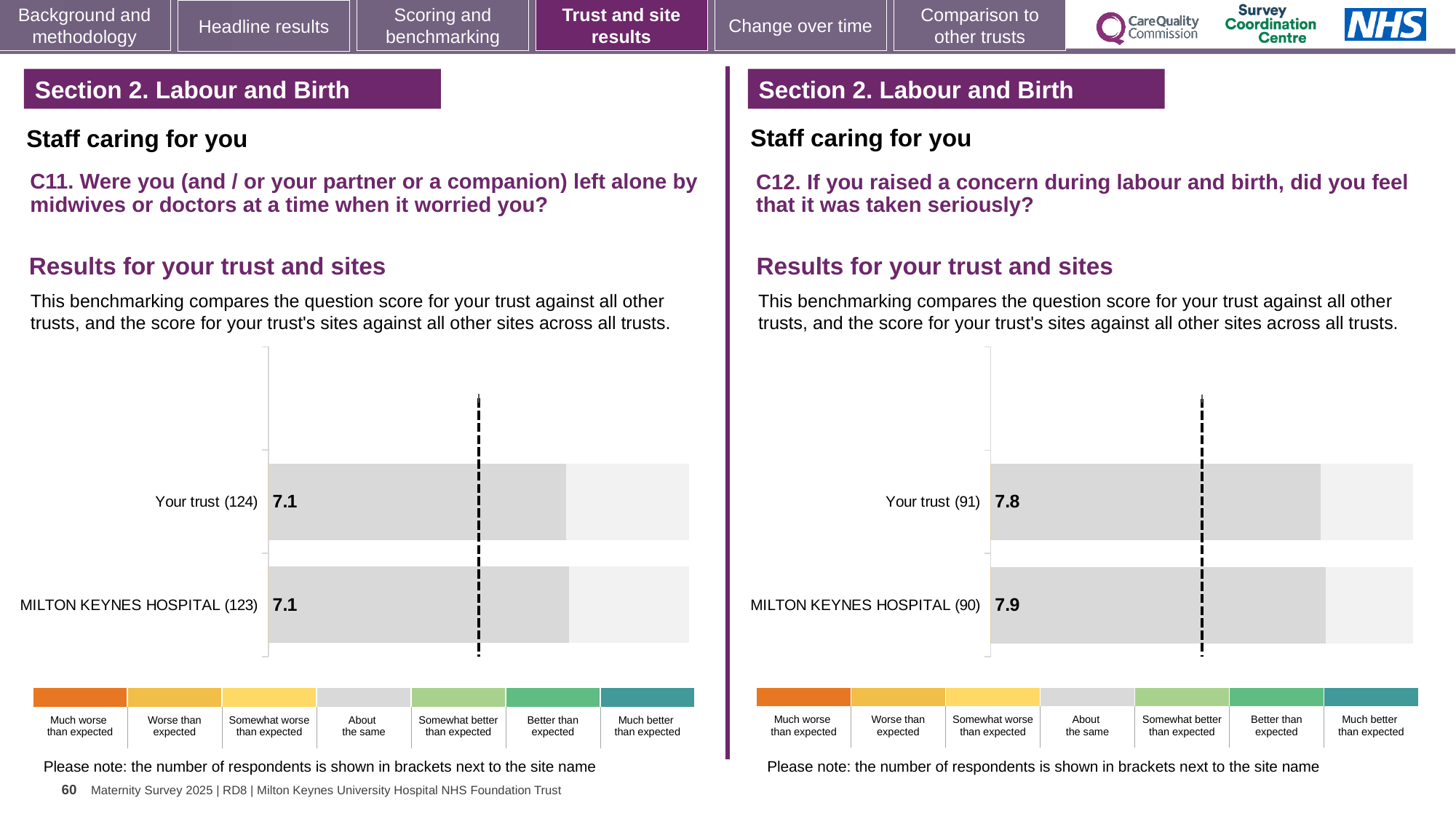
In the C12 chart on the right, what is the difference between the MILTON KEYNES HOSPITAL score and the Your trust score? 0.1 How many bars are plotted in the C11 chart on the left? 2 In the C11 chart on the left, what is the score for Your trust? 7.1 What type of chart is used for the C12 results on the right? Bar chart In the C11 chart on the left, what is the difference between the Your trust score and the MILTON KEYNES HOSPITAL score? 0 In the C11 chart on the left, how many respondents are shown in brackets for Your trust? 124 In the C12 chart on the right, what is the score for Your trust? 7.8 In the C12 chart on the right, which has the higher score, Your trust or MILTON KEYNES HOSPITAL? MILTON KEYNES HOSPITAL In the C12 chart on the right, how many respondents are shown in brackets for MILTON KEYNES HOSPITAL? 90 In the C12 chart on the right, what is the score for MILTON KEYNES HOSPITAL? 7.9 In the C11 chart on the left, what is the score for MILTON KEYNES HOSPITAL? 7.1 How many benchmarking categories does the colour key below the C11 chart on the left list? 7